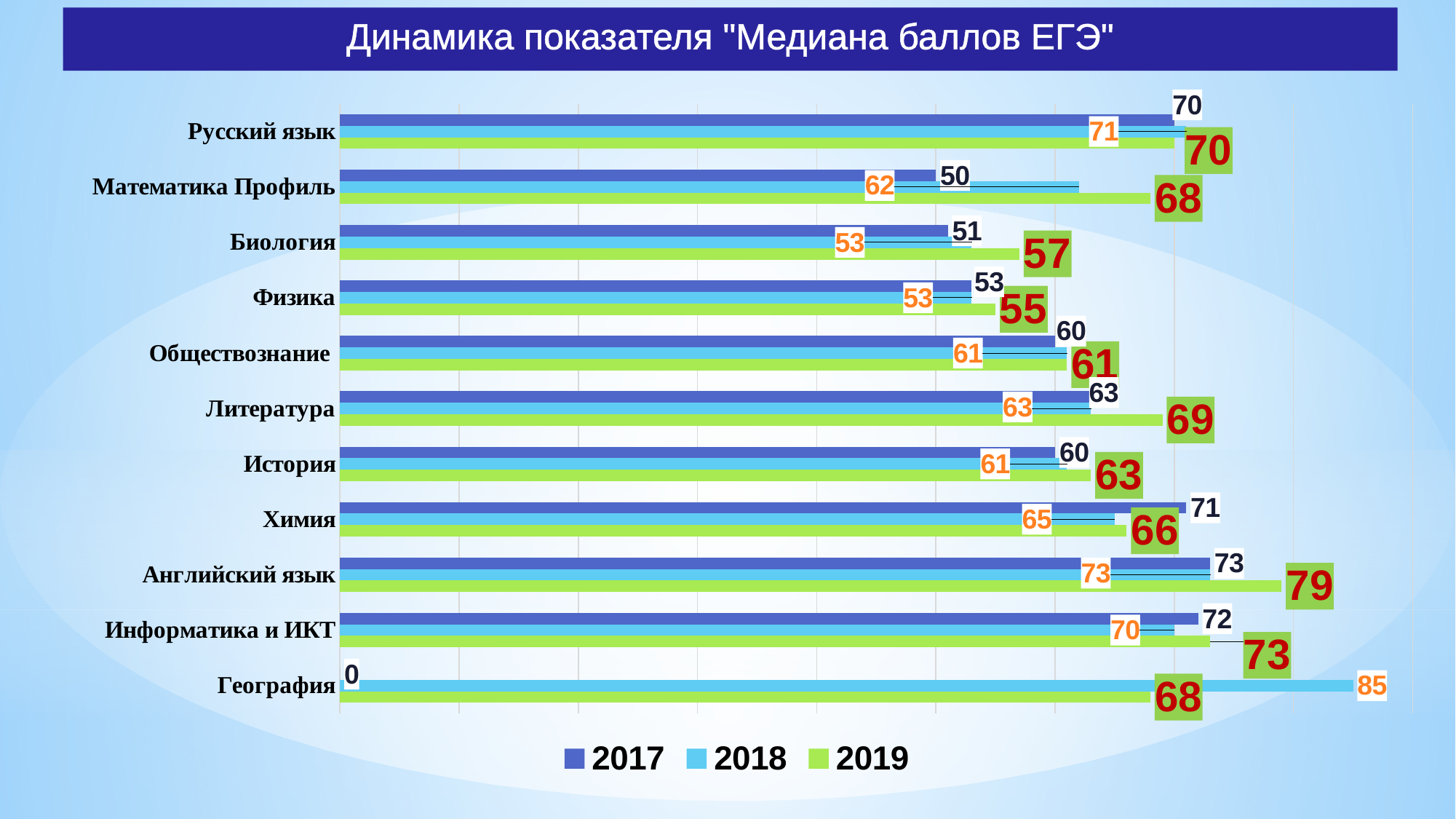
Do the values for Математика Профиль rise or fall from 2017 to 2019? rise What is the 2018 value for География? 85 What is the 2019 value for Английский язык? 79 What is the difference between the 2019 and 2017 values for Математика Профиль? 18 What is the 2017 value for Математика Профиль? 50 How many subject categories are shown on the chart? 11 How many series does the legend list? 3 What kind of chart is shown on the slide? bar chart Which subject has the highest 2019 value? Английский язык Which subject has the lowest 2019 value? Физика What are the entries listed in the legend? 2017, 2018, 2019 For Химия, which is larger: the 2017 value or the 2019 value? 2017